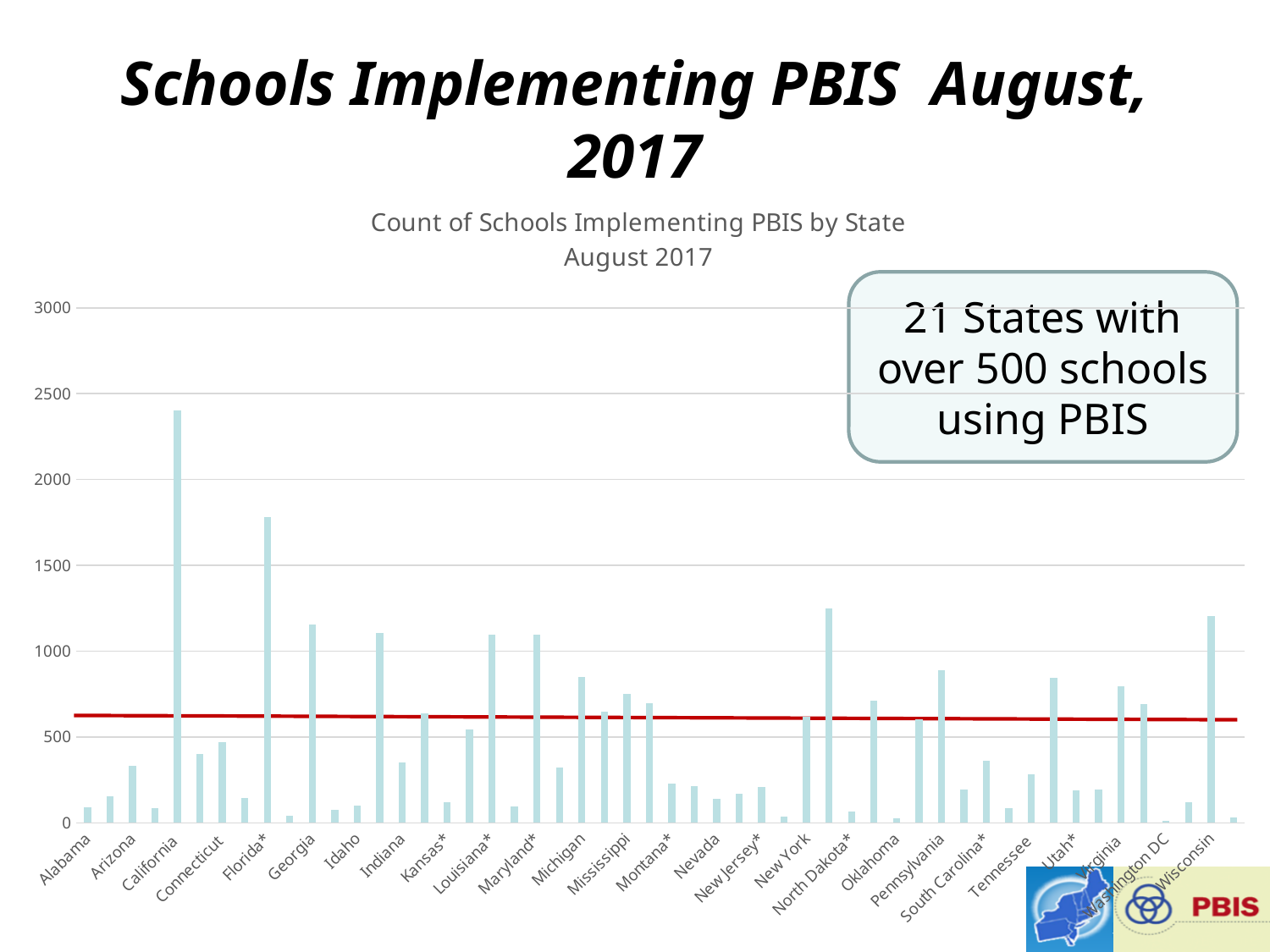
What is the title of the chart? Count of Schools Implementing PBIS by State August 2017 According to the callout box on the slide, how many states have over 500 schools using PBIS? 21 Which has more schools implementing PBIS, Georgia or Nevada? Georgia What kind of chart is shown on the slide? bar chart Which state has the highest count of schools implementing PBIS? California Is the value for Idaho greater or less than 500? less Which has more schools implementing PBIS, California or Florida*? California Is the value for Wisconsin greater or less than 1000? greater Is the value for California greater or less than 2000? greater